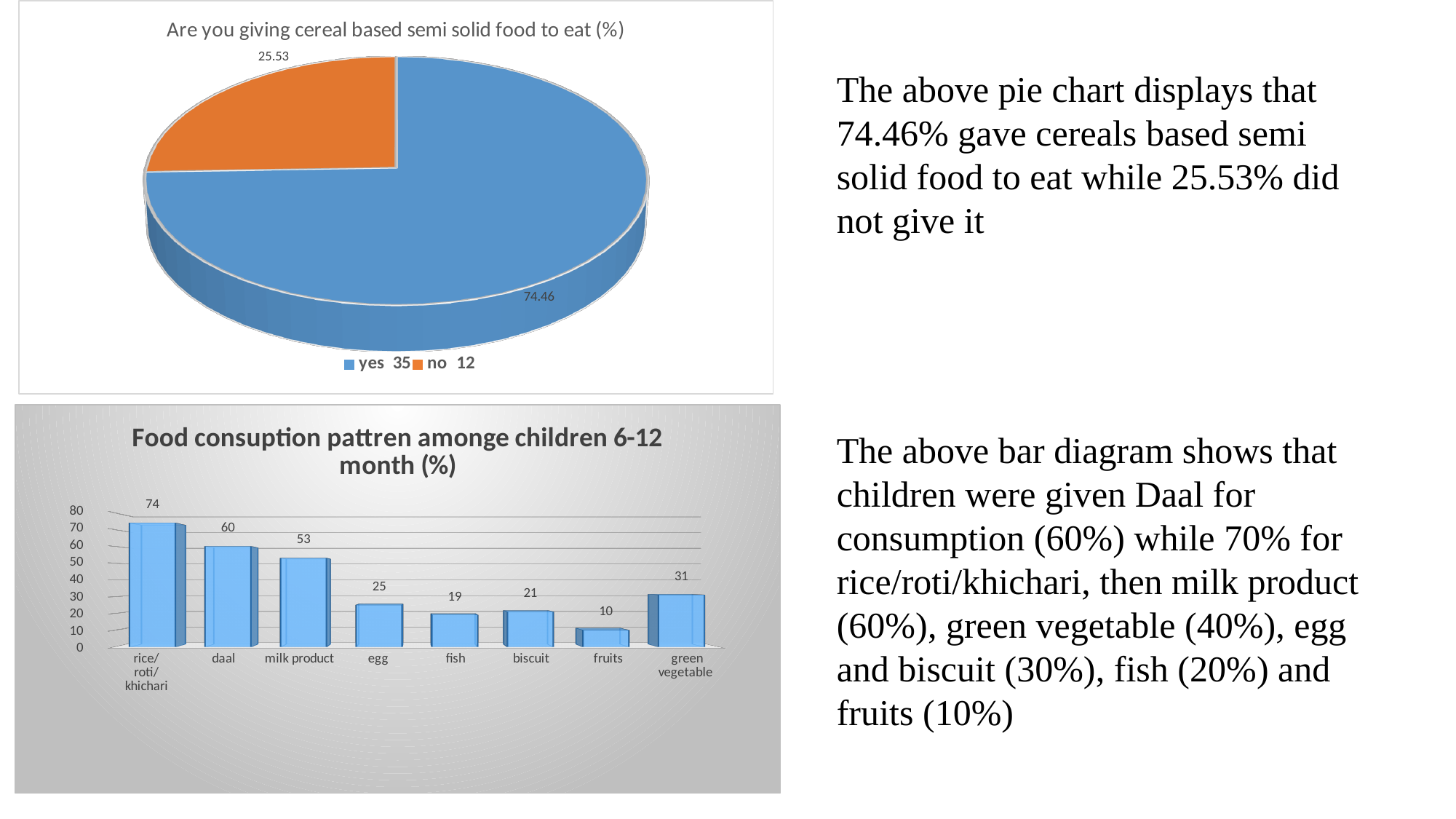
In the pie chart 'Are you giving cereal based semi solid food to eat (%)', how many slices does the pie have? 2 What type of chart is the bottom chart on the slide? bar chart In the pie chart 'Are you giving cereal based semi solid food to eat (%)', which slice is larger, 'yes' or 'no'? yes In the pie chart 'Are you giving cereal based semi solid food to eat (%)', what value is shown for the 'no' slice? 25.53 In the bar chart 'Food consuption pattren amonge children 6-12 month (%)', what is the value for daal? 60 In the bar chart 'Food consuption pattren amonge children 6-12 month (%)', how many food categories are shown? 8 In the bar chart 'Food consuption pattren amonge children 6-12 month (%)', what is the difference between the values for rice/roti/khichari and milk product? 21 In the bar chart 'Food consuption pattren amonge children 6-12 month (%)', which category has the highest value? rice/roti/khichari In the bar chart 'Food consuption pattren amonge children 6-12 month (%)', what is the value for green vegetable? 31 In the bar chart 'Food consuption pattren amonge children 6-12 month (%)', which category has the lowest value? fruits In the pie chart 'Are you giving cereal based semi solid food to eat (%)', what value is shown for the 'yes' slice? 74.46 What type of chart is the top chart on the slide? pie chart